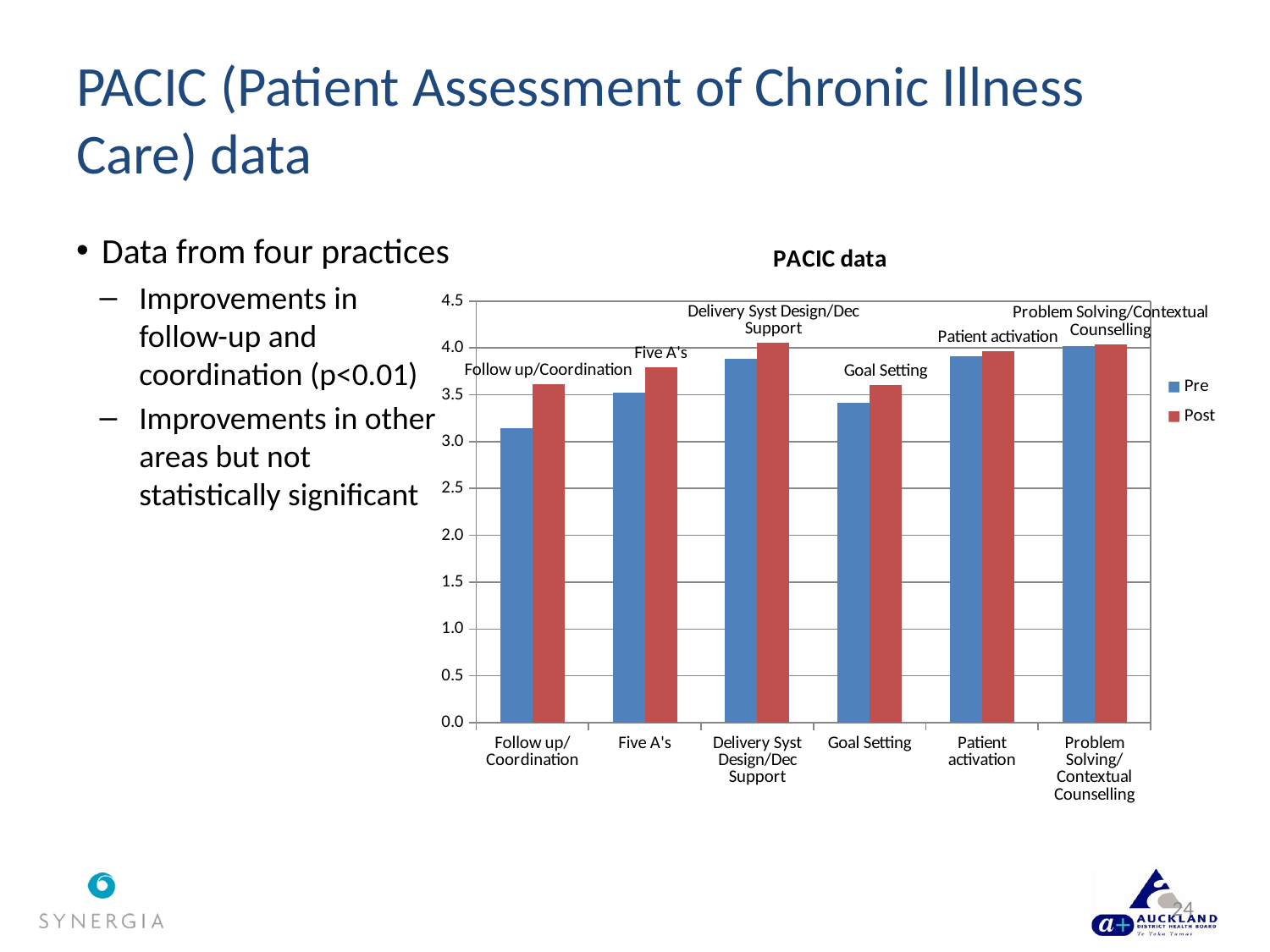
What is the title of the chart? PACIC data Is the Post value for Delivery Syst Design/Dec Support greater or less than 4.0? greater How many series does the chart legend list? 2 Which category has the lowest Pre value? Follow up/Coordination Is the Pre value for Goal Setting greater or less than 3.5? less Which is larger, the Pre value for Follow up/Coordination or the Pre value for Five A's? Five A's What type of chart is shown on the slide? Bar chart How many categories are shown on the x axis of the chart? 6 For Follow up/Coordination, which is larger, the Pre value or the Post value? Post Is the Post value for Five A's greater or less than 3.5? greater Which series is shown in red in the chart? Post